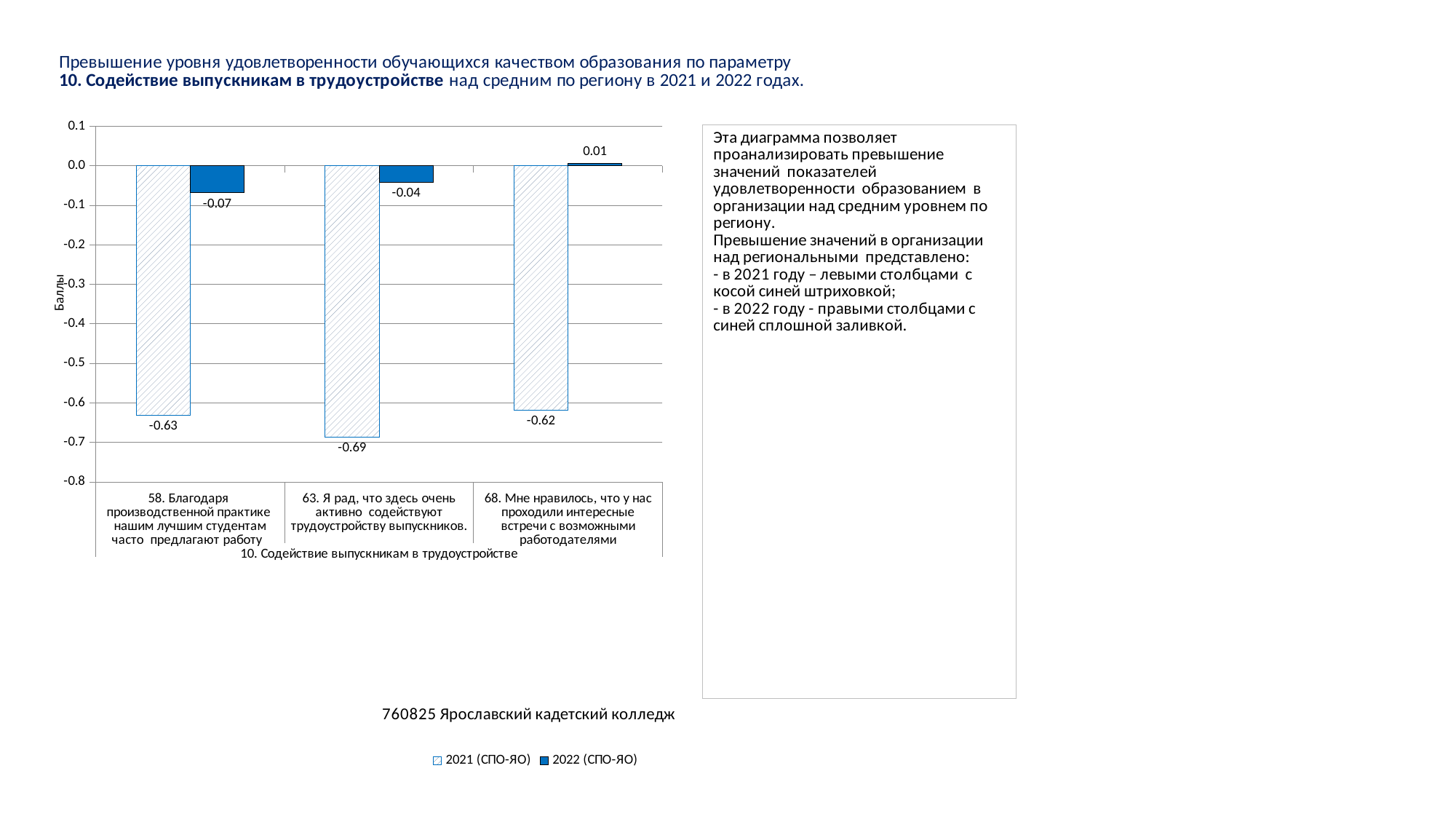
Which category has the highest value for the 2022 (СПО-ЯО) series? 68. Мне нравилось, что у нас проходили интересные встречи с возможными работодателями Is the 2021 value for category 68 greater or less than -0.5? less What is the value for 2021 (СПО-ЯО) for category 58 (Благодаря производственной практике нашим лучшим студентам часто предлагают работу)? -0.63 Which is larger: the 2021 value for category 58 or the 2021 value for category 63? Category 58 (-0.63) What is the value for 2022 (СПО-ЯО) for category 63 (Я рад, что здесь очень активно содействуют трудоустройству выпускников)? -0.04 What type of chart is shown on the slide? Bar chart What is the difference between the 2021 values for category 63 and category 68? 0.07 Which category has the lowest value for the 2021 (СПО-ЯО) series? 63. Я рад, что здесь очень активно содействуют трудоустройству выпускников. How many categories are shown on the x axis? 3 What is the difference between the 2022 and 2021 values for category 58? 0.56 What is the value for 2022 (СПО-ЯО) for category 68 (Мне нравилось, что у нас проходили интересные встречи с возможными работодателями)? 0.01 How many series does the legend list? 2